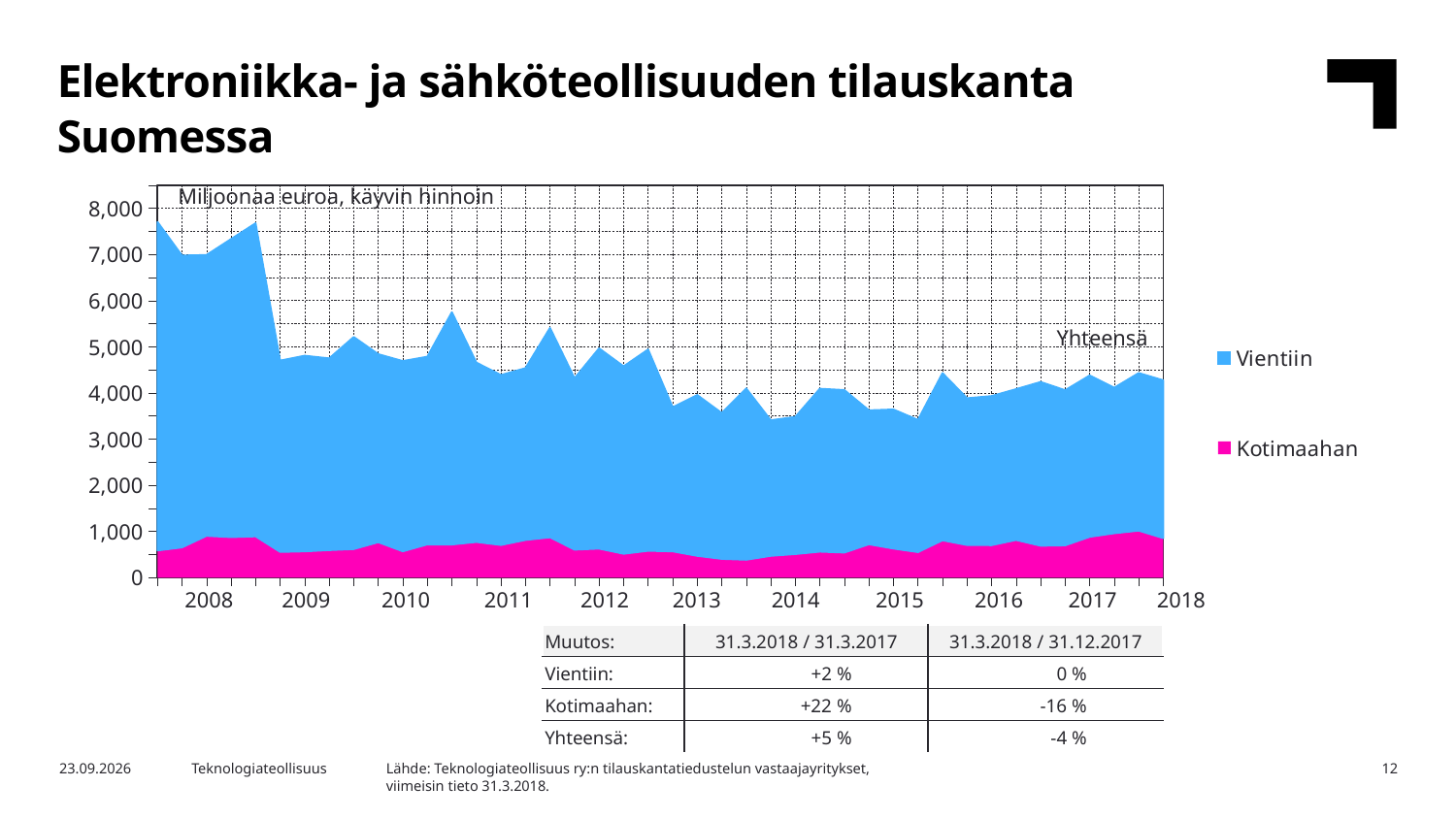
Is the Kotimaahan value in 2017 greater or less than 2,000? less Is the total value at the start of 2009 greater or less than 6,000? less What are the two series named in the chart's legend? Vientiin and Kotimaahan Which series is larger throughout the chart, Vientiin or Kotimaahan? Vientiin Is the total value in 2016 greater or less than 5,000? less How many series does the chart's legend list? 2 What unit is stated in the label at the top of the chart? Miljoonaa euroa, käyvin hinnoin What kind of chart is shown on the slide? Stacked area chart In which year does the total order book reach its highest level? 2008 Overall, do the total values rise or fall from 2008 to 2018? fall How many year labels are shown on the x axis? 11